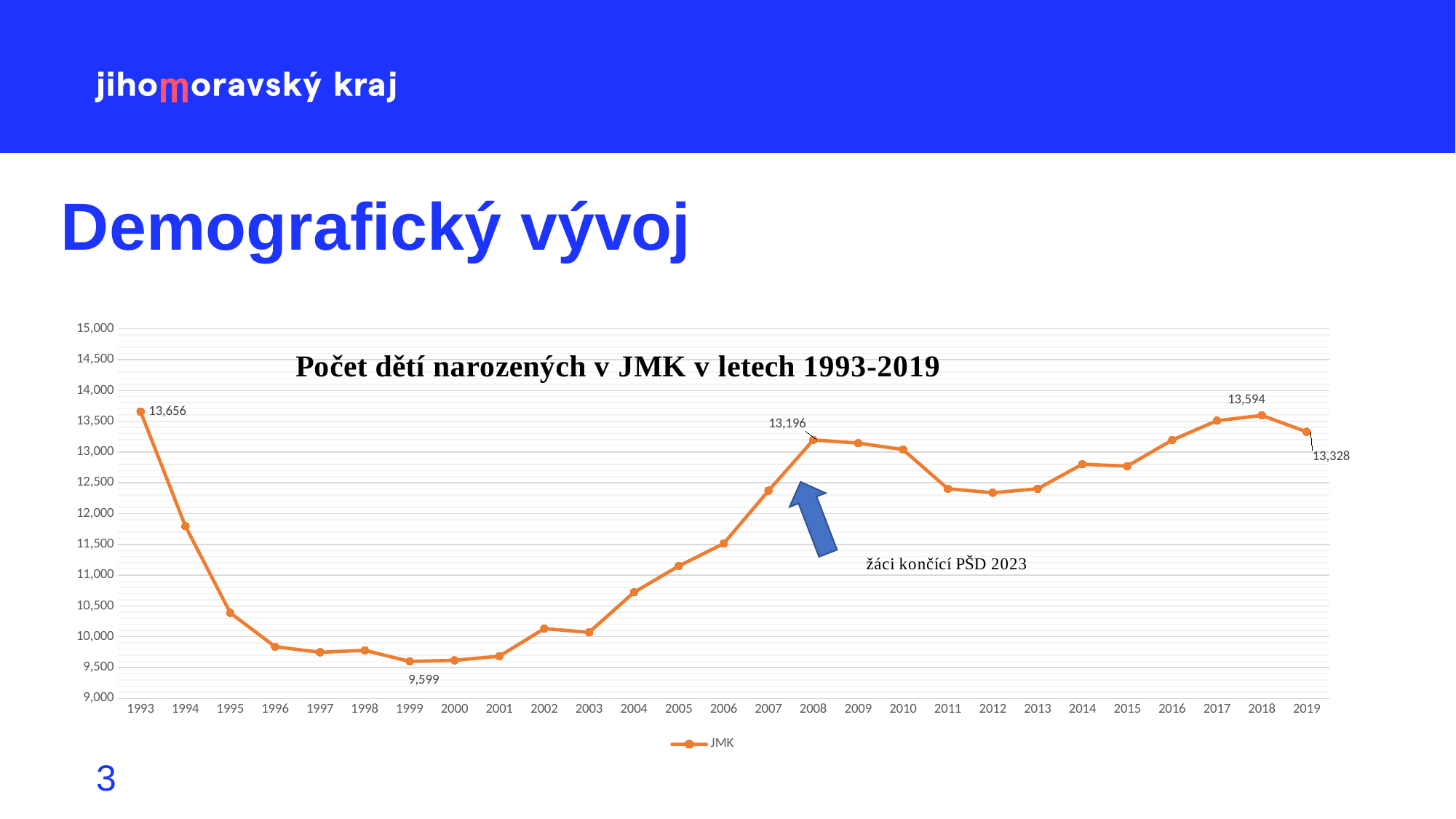
What is the value for 2019? 13,328 Which year has the highest value? 1993 How many series does the legend list? 1 What is the value for 2008? 13,196 What type of chart is shown on the slide? line chart Is the value for 2012 greater or less than 12,500? less How many years (data points) are plotted on the x axis? 27 What is the difference between the values for 2018 and 2019? 266 Do the values rise or fall from 2001 to 2008? rise What is the difference between the values for 1993 and 2018? 62 What is the value for 1993? 13,656 What is the title of the chart? Počet dětí narozených v JMK v letech 1993-2019